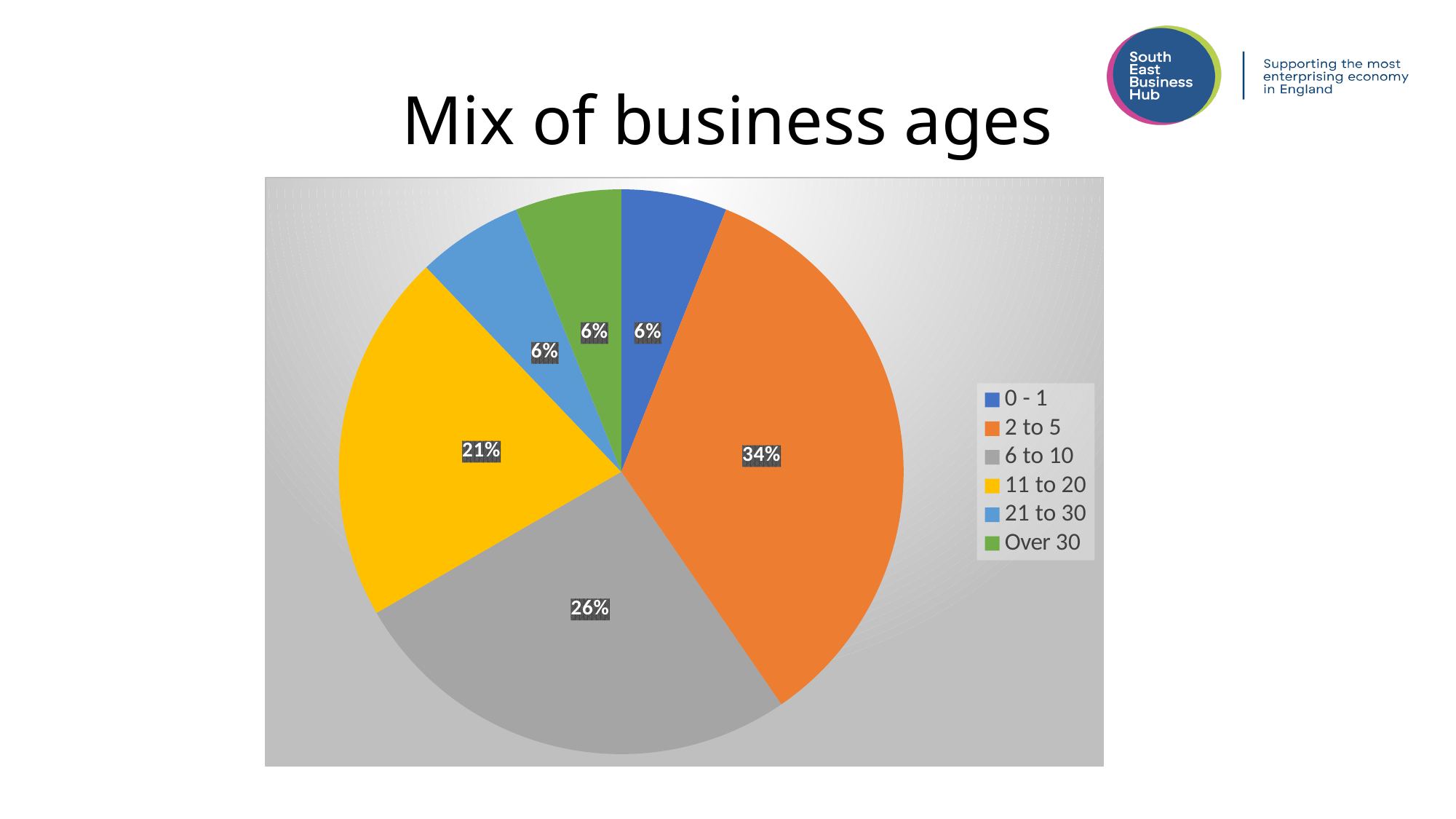
What share of businesses are aged 2 to 5 years? 34% What share of businesses are aged 0 - 1 years? 6% Which business age group has the largest share of the pie? 2 to 5 How many entries does the legend list? 6 What share of businesses are aged 6 to 10 years? 26% How many slices does the pie chart have? 6 What share of businesses are aged 11 to 20 years? 21% What colour is the slice for the Over 30 age group? green What is the title of the chart? Mix of business ages What is the difference in percentage points between the 2 to 5 slice and the 6 to 10 slice? 8 What kind of chart is shown on the slide? pie chart Which is larger, the share for 11 to 20 or the share for 6 to 10? 6 to 10